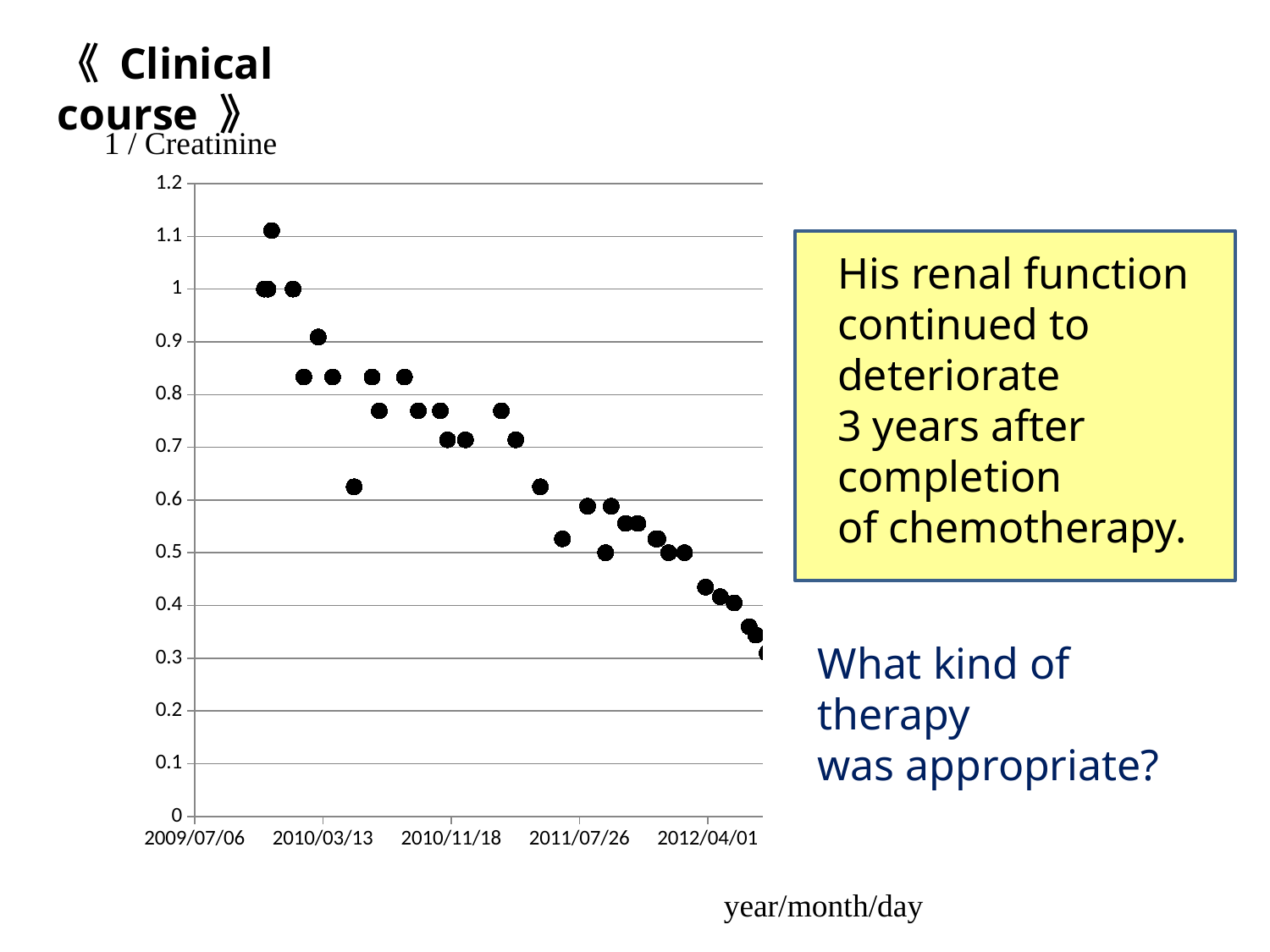
What is the label of the y axis? 1 / Creatinine Is the highest plotted 1 / Creatinine value greater or less than 1? greater Is the value plotted near 2011/07/26 greater or less than 0.7? less What is the last date shown on the x axis? 2012/04/01 What kind of chart is shown on the slide? scatter chart What is the maximum value shown on the y axis? 1.2 Is the lowest plotted 1 / Creatinine value greater or less than 0.4? less Do the 1 / Creatinine values rise or fall over time along the x axis? fall What is the first date shown on the x axis? 2009/07/06 What is the label of the x axis? year/month/day